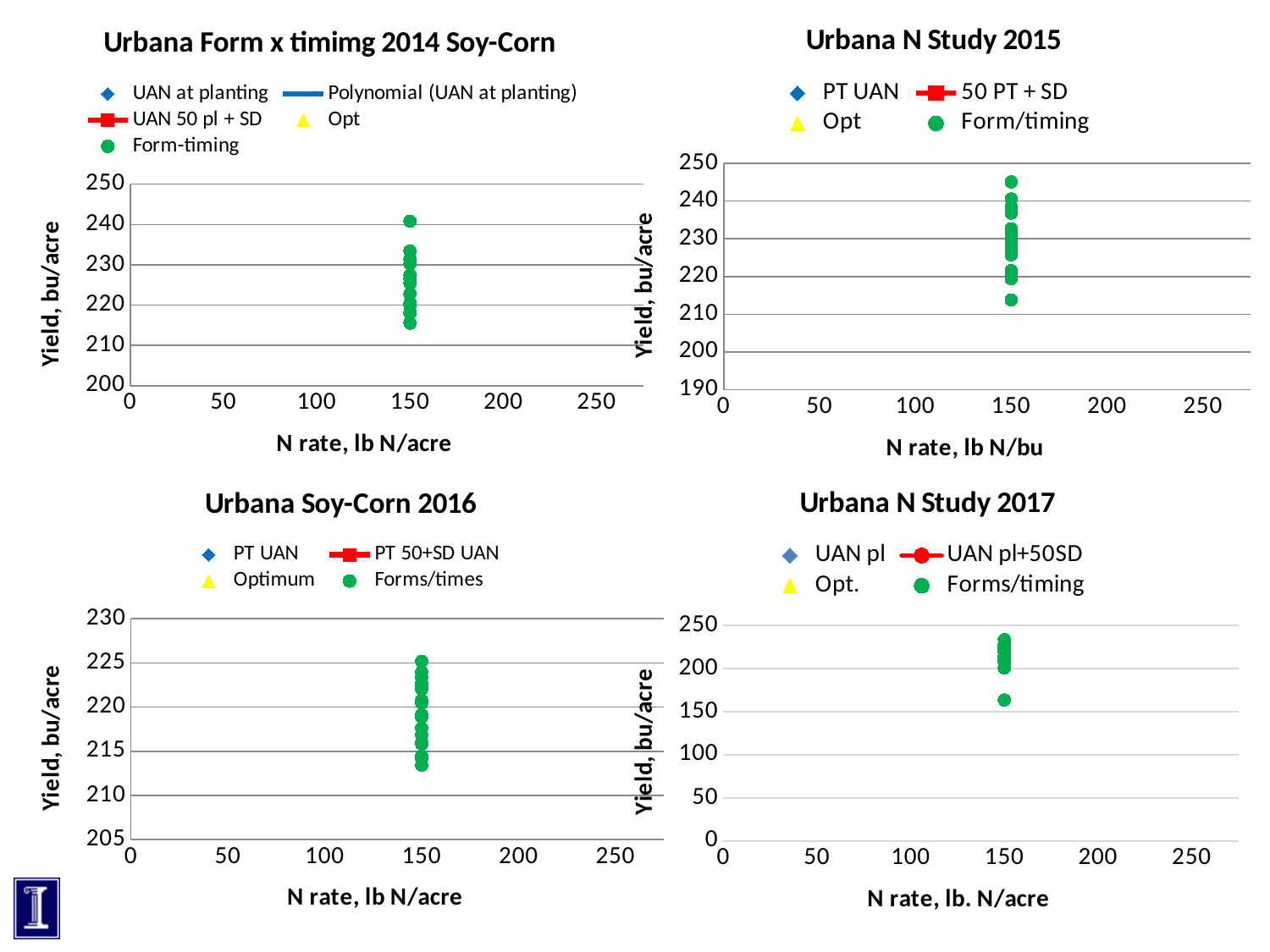
In the "Urbana N Study 2017" chart, is the lowest Forms/timing yield greater or less than 200? less How many series does the legend of the "Urbana Soy-Corn 2016" chart list? 4 In the "Urbana Form x timimg 2014 Soy-Corn" chart, is the lowest Form-timing yield greater or less than 220? less In the "Urbana N Study 2015" chart, is the lowest Form/timing yield greater or less than 220? less What is the y-axis label of the "Urbana N Study 2017" chart? Yield, bu/acre How many series does the legend of the "Urbana Form x timimg 2014 Soy-Corn" chart list? 5 How many series does the legend of the "Urbana N Study 2015" chart list? 4 What kind of chart is "Urbana Form x timimg 2014 Soy-Corn"? scatter chart What is the x-axis label of the "Urbana N Study 2015" chart? N rate, lb N/bu How many charts are shown on the slide? 4